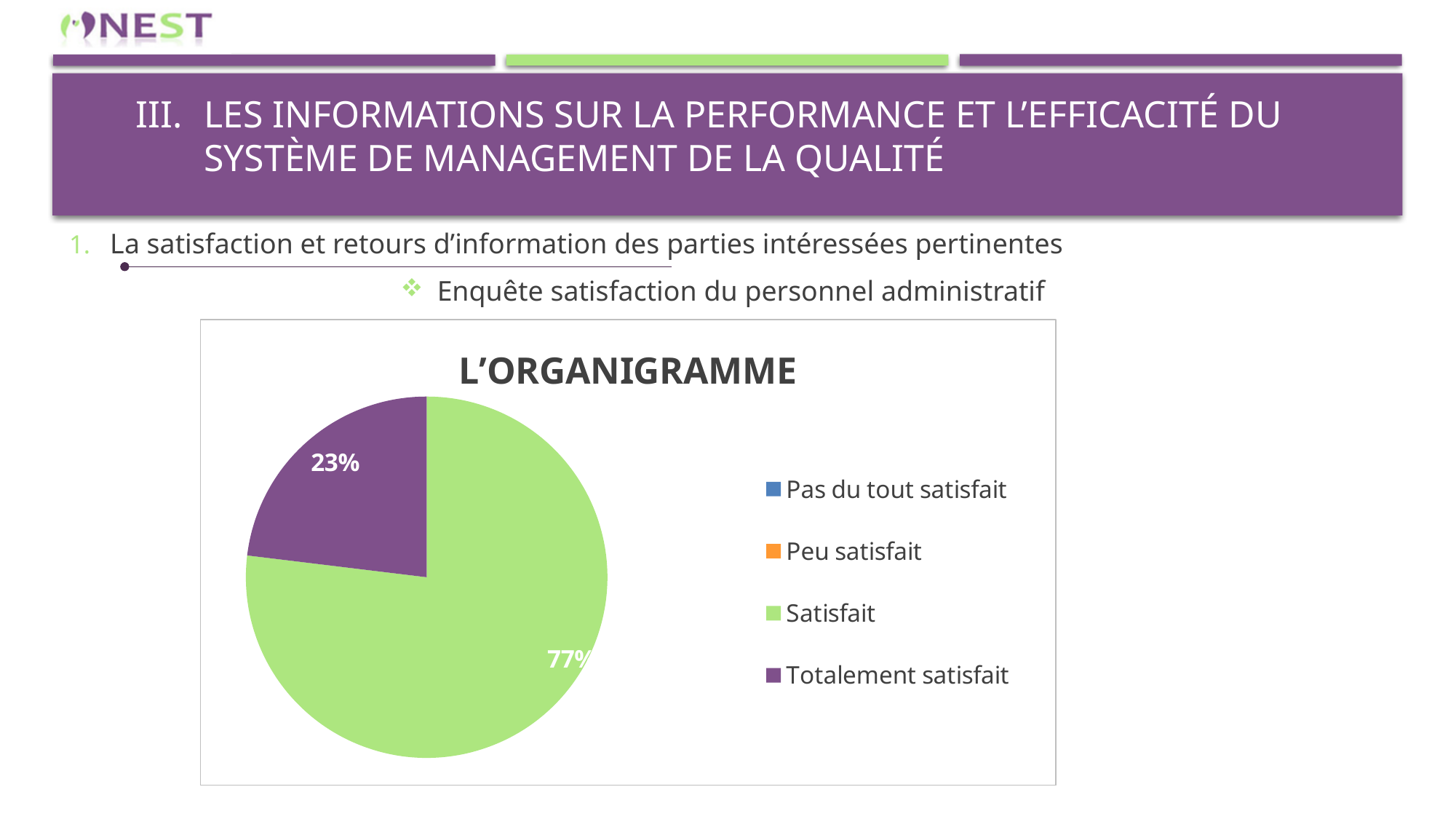
How many slices are visible in the pie? 2 Which of the two visible slices is larger, 'Satisfait' or 'Totalement satisfait'? Satisfait How many categories does the legend list? 4 What is the title of the chart? L'ORGANIGRAMME What type of chart is shown on the slide? pie chart What colour is the 'Satisfait' slice? green Which category has the largest slice of the pie? Satisfait Is the share for 'Totalement satisfait' greater or less than 50%? less What is the difference in percentage points between the 'Satisfait' and 'Totalement satisfait' slices? 54 What share of the pie is labelled 'Totalement satisfait'? 23% What share of the pie is labelled 'Satisfait'? 77%